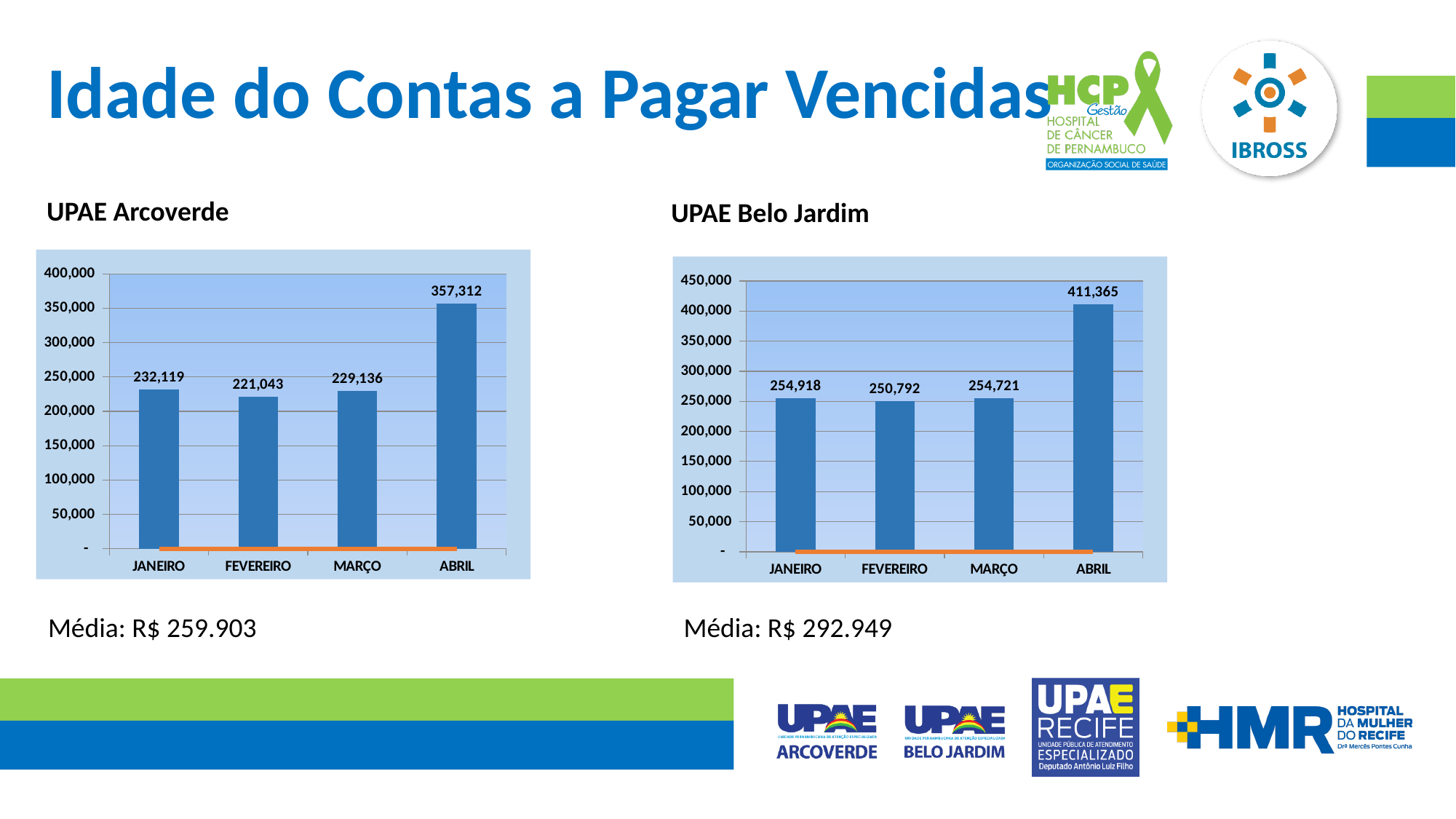
In the UPAE Arcoverde chart, which is larger, the value for JANEIRO or the value for FEVEREIRO? JANEIRO In the UPAE Arcoverde chart, what is the value for FEVEREIRO? 221,043 In the UPAE Arcoverde chart, which month has the highest value? ABRIL In the UPAE Arcoverde chart, what is the value for ABRIL? 357,312 In the UPAE Belo Jardim chart, which month has the lowest value? FEVEREIRO What kind of chart is the UPAE Arcoverde chart? Bar chart How many months are shown in the UPAE Belo Jardim chart? 4 In the UPAE Arcoverde chart, what is the difference between the ABRIL and JANEIRO values? 125,193 In the UPAE Belo Jardim chart, what is the value for JANEIRO? 254,918 In the UPAE Arcoverde chart, which month has the lowest value? FEVEREIRO In the UPAE Belo Jardim chart, what is the value for ABRIL? 411,365 In the UPAE Belo Jardim chart, what is the difference between the ABRIL and FEVEREIRO values? 160,573